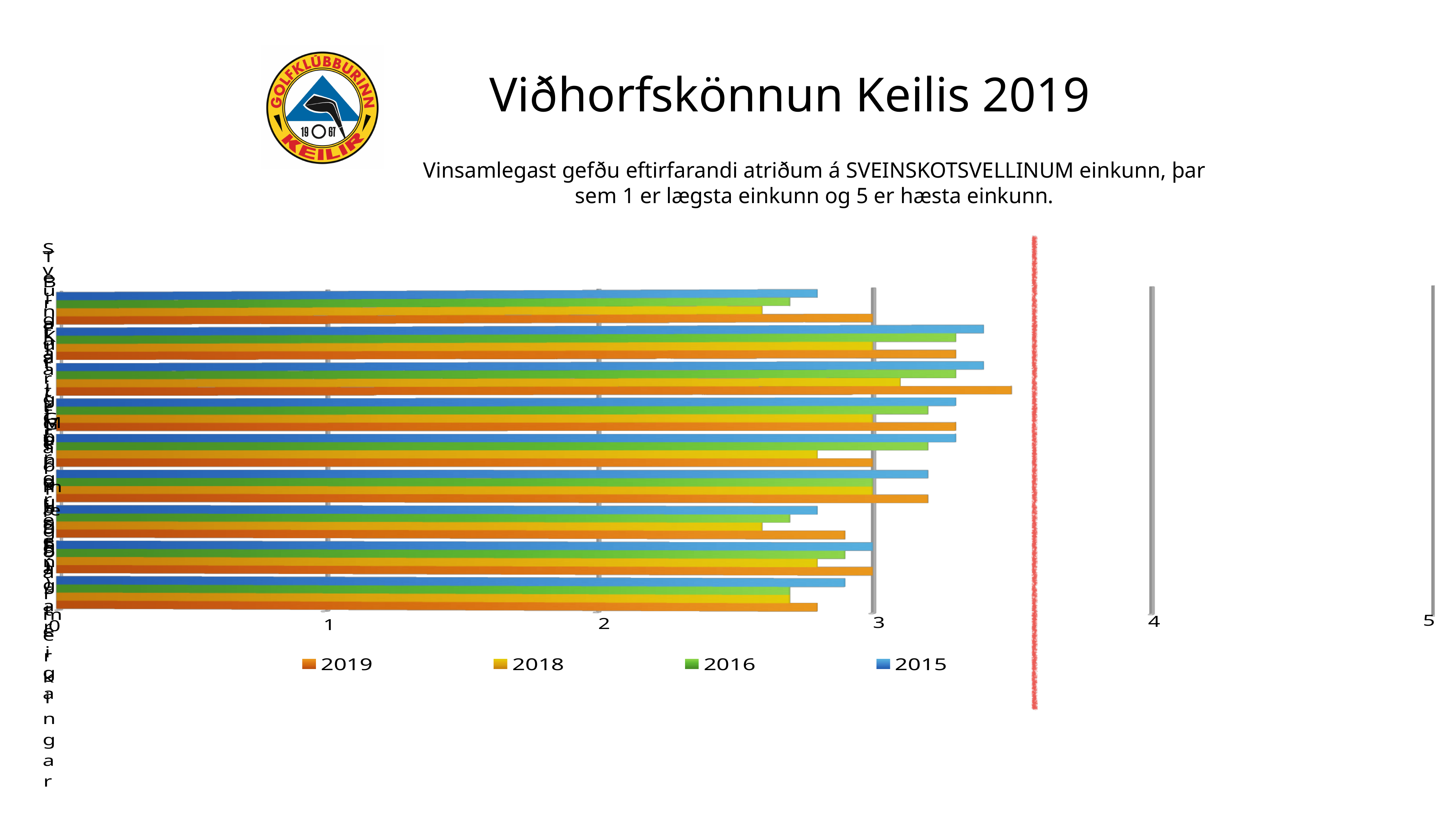
What is the title of the slide containing the chart? Viðhorfskönnun Keilis 2019 Which series is shown in blue in the legend? 2015 Is the longest bar on the chart greater or less than 3? greater What kind of chart is shown on the slide? bar chart Which series has the single longest bar on the chart? 2019 Is the longest bar on the chart greater or less than 4? less Is the shortest bar on the chart greater or less than 2? greater How many series does the legend list? 4 How many groups of bars (categories) are plotted on the chart? 9